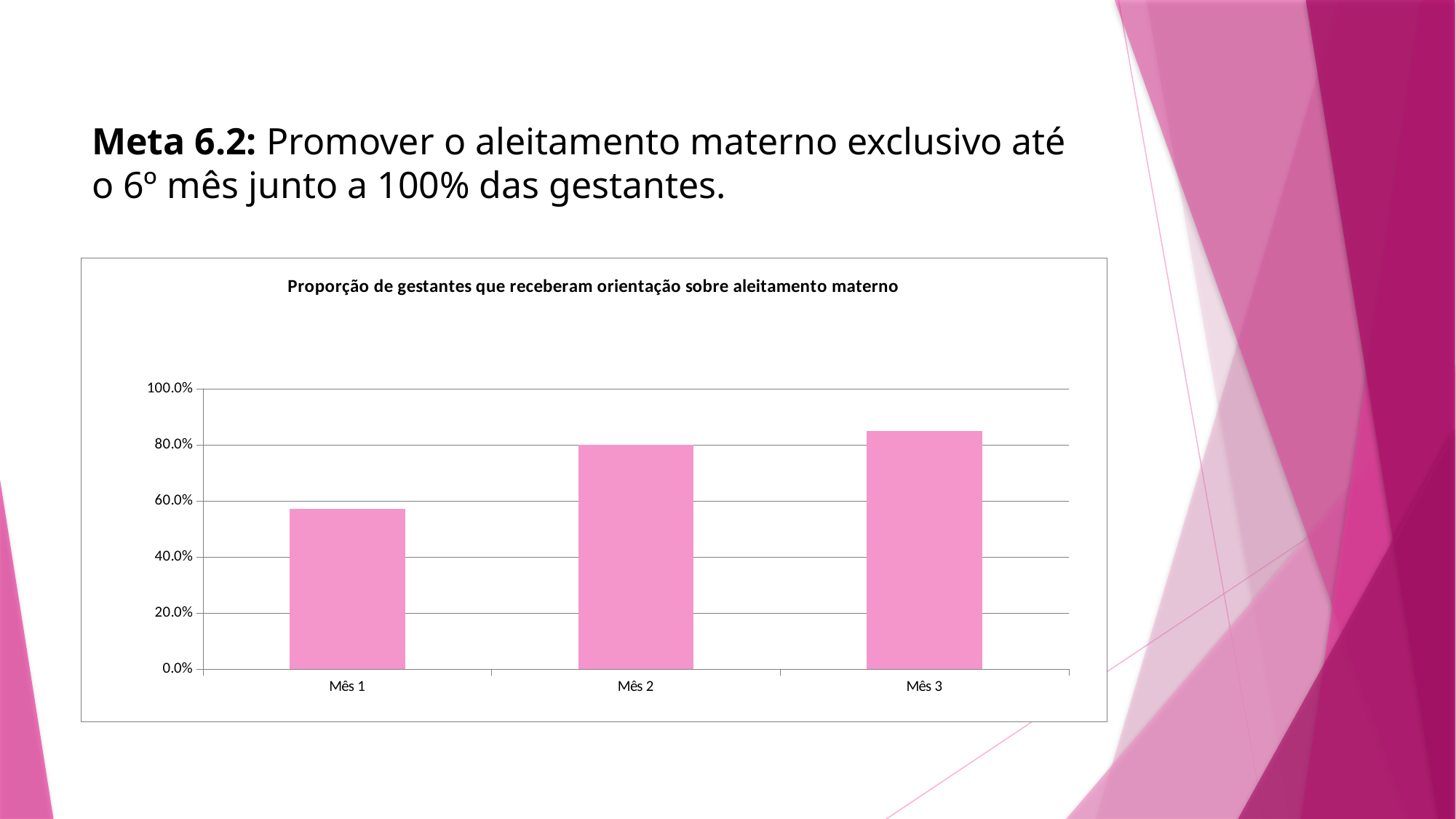
Is the value for Mês 1 greater or less than 40.0%? greater Which is larger, the value for Mês 1 or the value for Mês 2? Mês 2 Is the value for Mês 3 greater or less than 80.0%? greater Is the value for Mês 3 greater or less than 100.0%? less Which month has the highest proportion of pregnant women who received guidance on breastfeeding? Mês 3 Which is larger, the value for Mês 2 or the value for Mês 3? Mês 3 What is the title of the chart? Proporção de gestantes que receberam orientação sobre aleitamento materno Do the values rise or fall from Mês 1 to Mês 3? rise How many categories (months) are plotted on the chart? 3 What kind of chart is shown on the slide? bar chart Which month has the lowest proportion on the chart? Mês 1